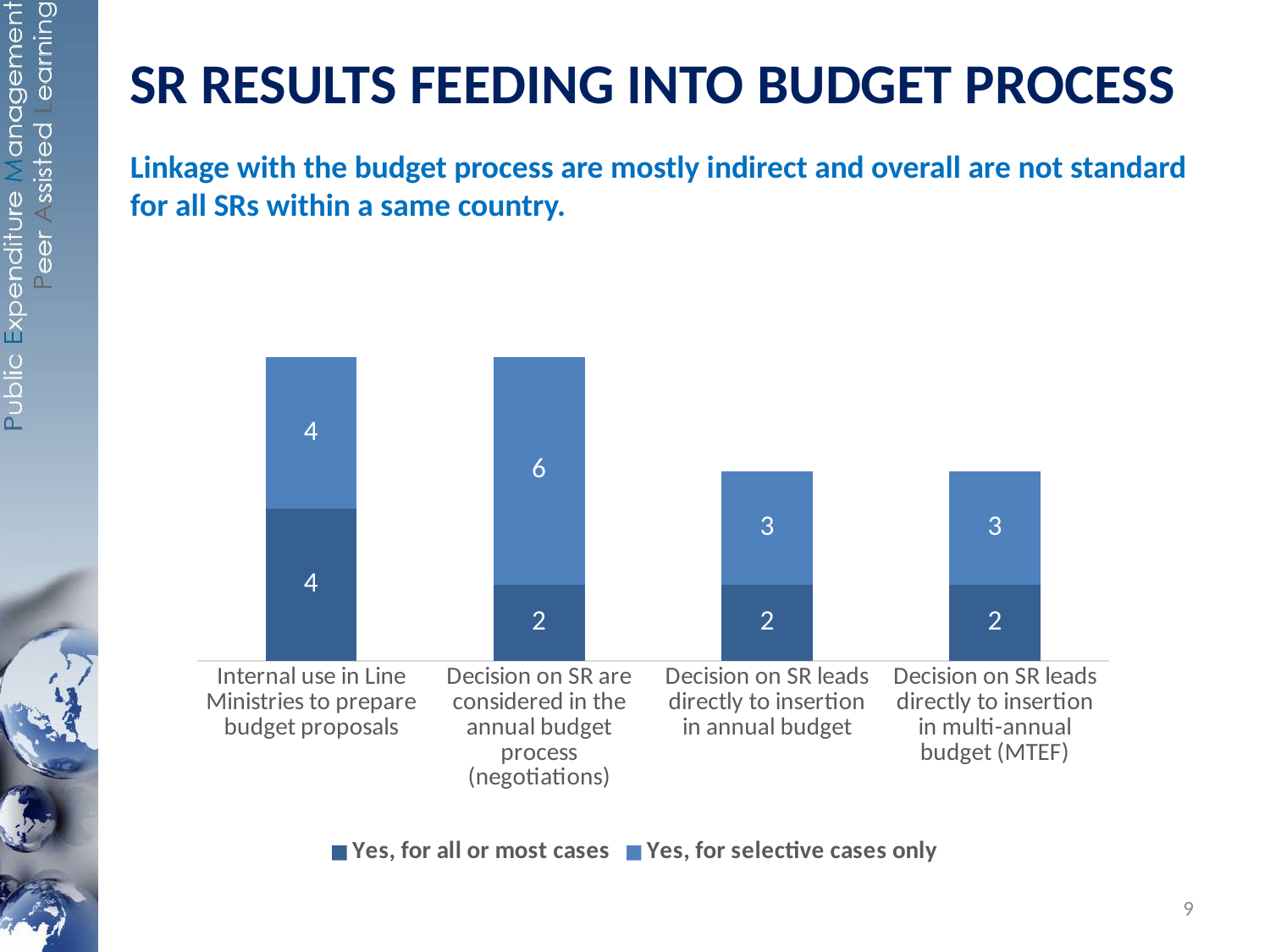
What is the total of the stacked bar for "Decision on SR are considered in the annual budget process (negotiations)"? 8 What is the value of "Yes, for all or most cases" for "Internal use in Line Ministries to prepare budget proposals"? 4 What is the difference between the "Yes, for selective cases only" values for "Decision on SR are considered in the annual budget process (negotiations)" and "Decision on SR leads directly to insertion in annual budget"? 3 What kind of chart is shown on the slide? Stacked bar chart How many categories are shown on the x axis? 4 Which category has the highest value for "Yes, for selective cases only"? Decision on SR are considered in the annual budget process (negotiations) What is the total of the stacked bar for "Decision on SR leads directly to insertion in annual budget"? 5 Which category has the highest value for "Yes, for all or most cases"? Internal use in Line Ministries to prepare budget proposals How many series does the legend list? 2 What is the value of "Yes, for selective cases only" for "Decision on SR leads directly to insertion in multi-annual budget (MTEF)"? 3 What is the value of "Yes, for all or most cases" for "Decision on SR leads directly to insertion in annual budget"? 2 What is the value of "Yes, for selective cases only" for "Decision on SR are considered in the annual budget process (negotiations)"? 6